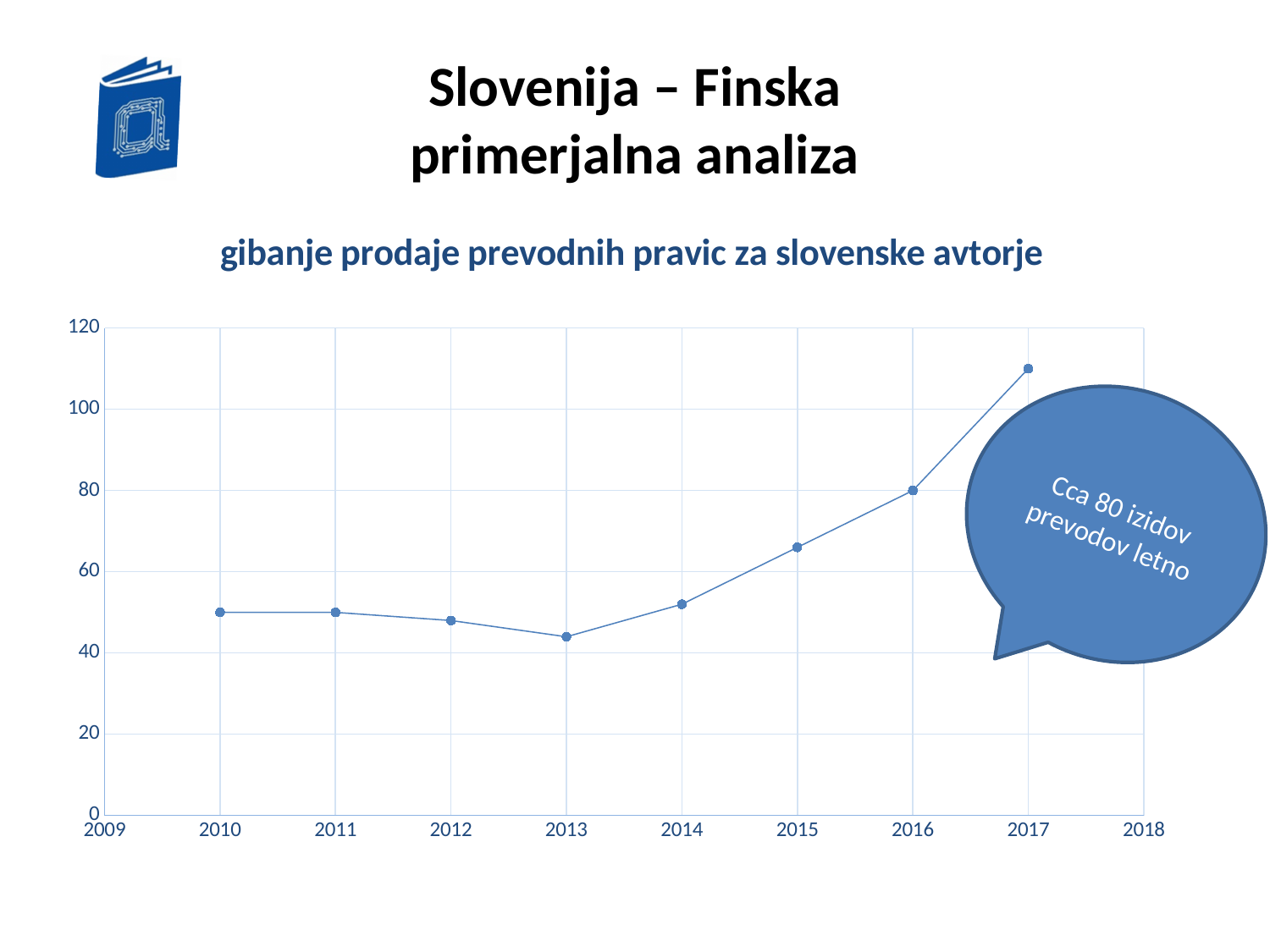
Which year has the lowest value? 2013 What is the value for 2016? 80 Is the value for 2015 greater or less than 60? greater What is the title of the chart? gibanje prodaje prevodnih pravic za slovenske avtorje Which year has the larger value, 2010 or 2017? 2017 Do the values rise or fall from 2013 to 2017? rise Is the value for 2010 greater or less than 40? greater How many data points are plotted on the line? 8 Is the value for 2017 greater or less than 100? greater Which year has the highest value? 2017 What kind of chart is shown on the slide? line chart